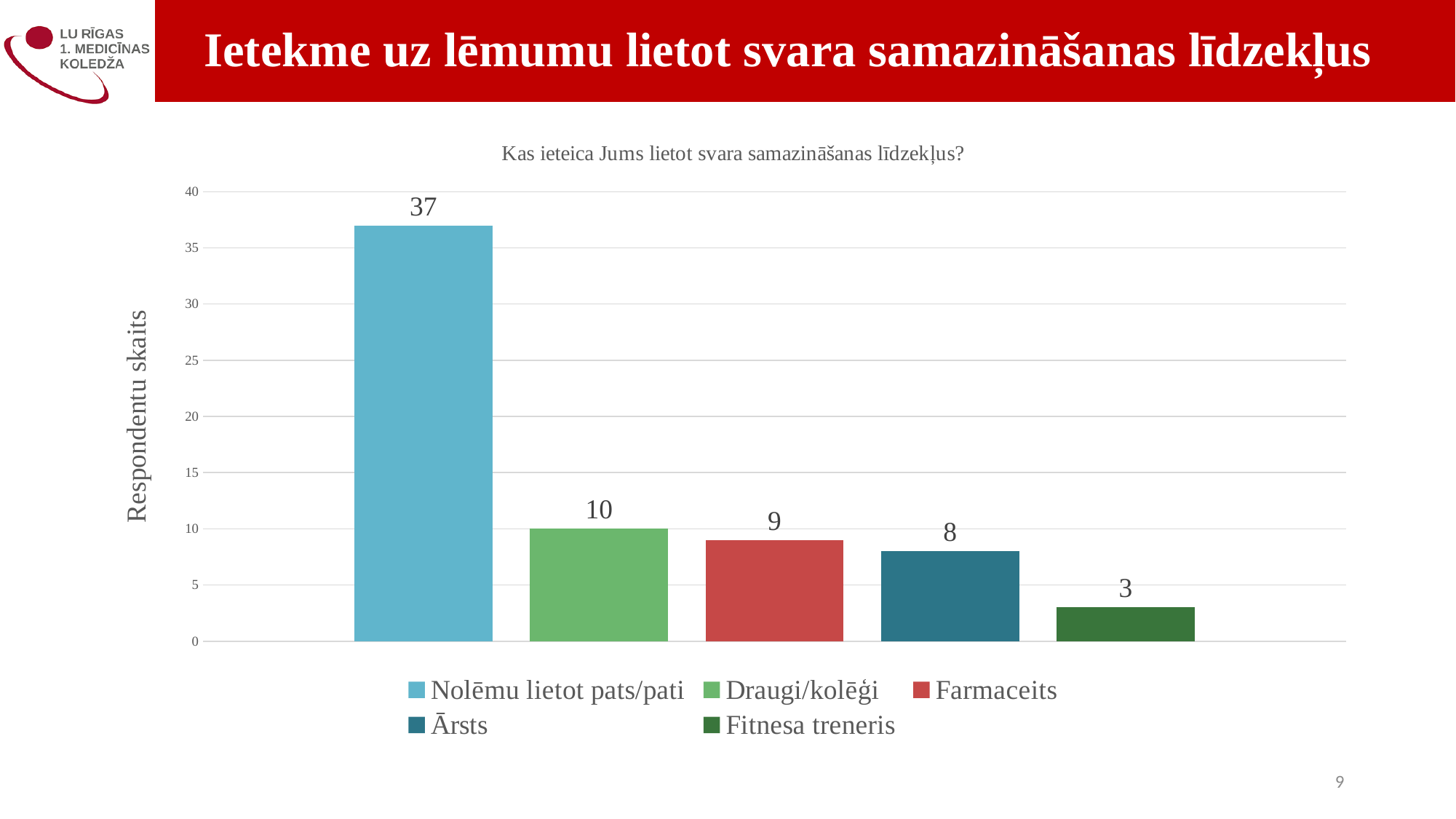
What is the title of the chart? Kas ieteica Jums lietot svara samazināšanas līdzekļus? What is the value for "Fitnesa treneris"? 3 What kind of chart is shown on the slide? Bar chart How many respondents chose "Nolēmu lietot pats/pati"? 37 Which category has the highest number of respondents? Nolēmu lietot pats/pati What is the difference between the values for "Ārsts" and "Fitnesa treneris"? 5 Which category has the lowest number of respondents? Fitnesa treneris How many categories are shown in the chart? 5 Which is larger, the value for "Draugi/kolēģi" or the value for "Ārsts"? Draugi/kolēģi What is the value for "Farmaceits"? 9 What is the difference between the values for "Nolēmu lietot pats/pati" and "Draugi/kolēģi"? 27 What is the label of the vertical axis? Respondentu skaits